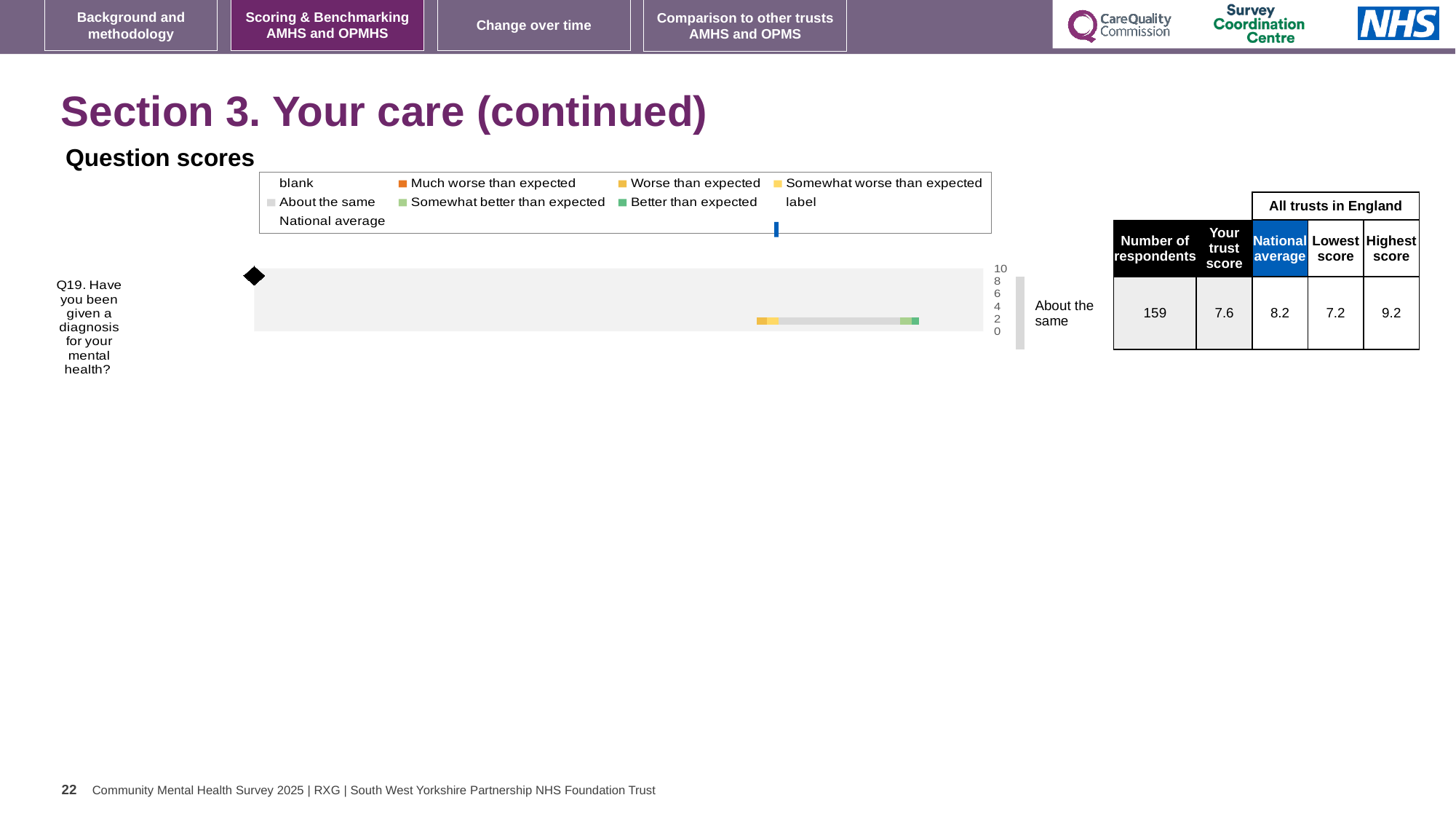
What is the national average score for Q19 according to the table? 8.2 Which is larger for Q19, the trust's score or the national average? National average What kind of chart is used to show the Q19 question score? bar chart How many legend entries contain the phrase 'than expected'? 5 How many survey questions are plotted in the Question scores chart? 1 What is the difference between the highest and lowest scores for Q19 across all trusts in England? 2.0 Is the trust's score for Q19 greater or less than 8? less What is the highest score among all trusts in England for Q19? 9.2 What is the trust's score for Q19 according to the table? 7.6 How many respondents answered Q19? 159 What rating label is shown next to the bar for Q19? About the same Which question is plotted in the Question scores chart? Q19. Have you been given a diagnosis for your mental health?